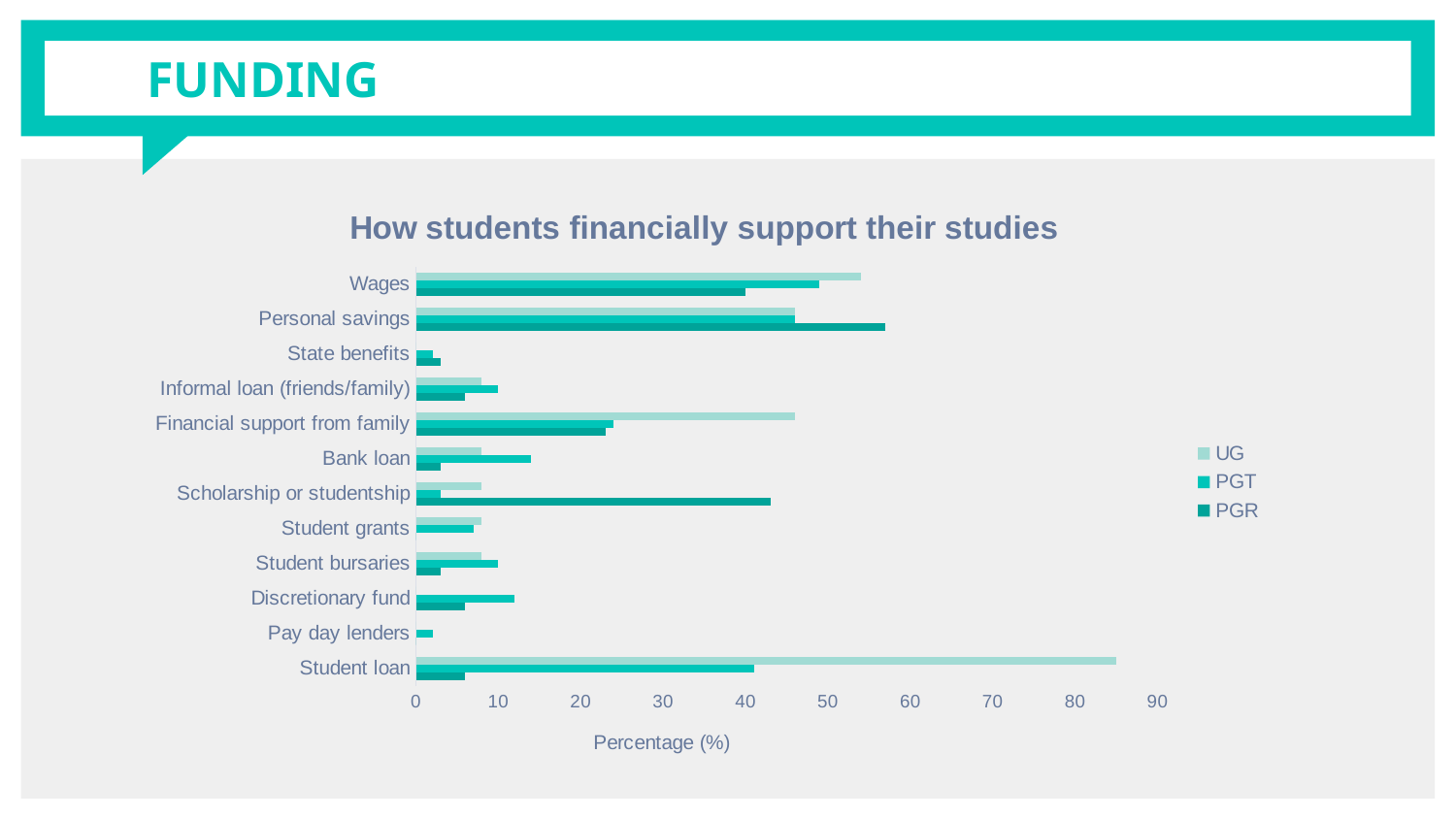
For Scholarship or studentship, which series has the larger value, UG or PGR? PGR Is the UG value for Student loan greater or less than 80? greater For Financial support from family, which series has the larger value, UG or PGR? UG Is the PGR value for Student loan greater or less than 10? less How many funding categories are plotted on the chart? 12 Which category has the highest value for the PGR series? Personal savings What kind of chart is shown on the slide? bar chart Is the PGR value for Scholarship or studentship greater or less than 30? greater Which category has the highest value for the UG series? Student loan How many series does the legend list? 3 What is the label on the horizontal axis of the chart? Percentage (%)